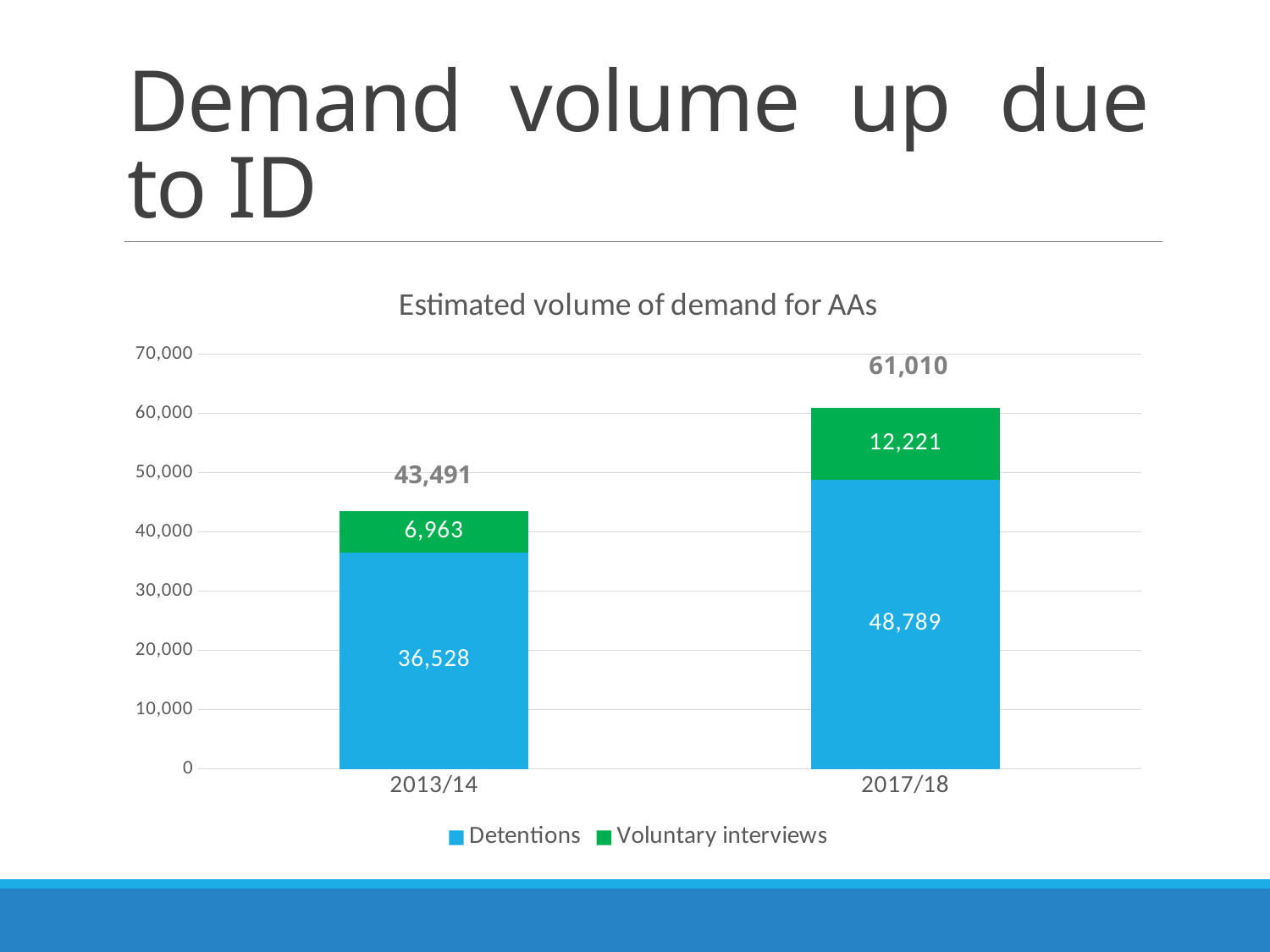
What kind of chart is shown on the slide? Stacked bar chart What is the title of the chart? Estimated volume of demand for AAs Is the total for 2013/14 greater or less than 50,000? less What is the total of the stacked bar for 2013/14? 43,491 What is the value for Detentions in 2017/18? 48,789 What is the value for Detentions in 2013/14? 36,528 What is the value for Voluntary interviews in 2013/14? 6,963 What is the difference between Detentions in 2017/18 and Detentions in 2013/14? 12,261 What is the value for Voluntary interviews in 2017/18? 12,221 What is the total of the stacked bar for 2017/18? 61,010 How many series does the legend list? 2 Which year has the higher total volume of demand? 2017/18